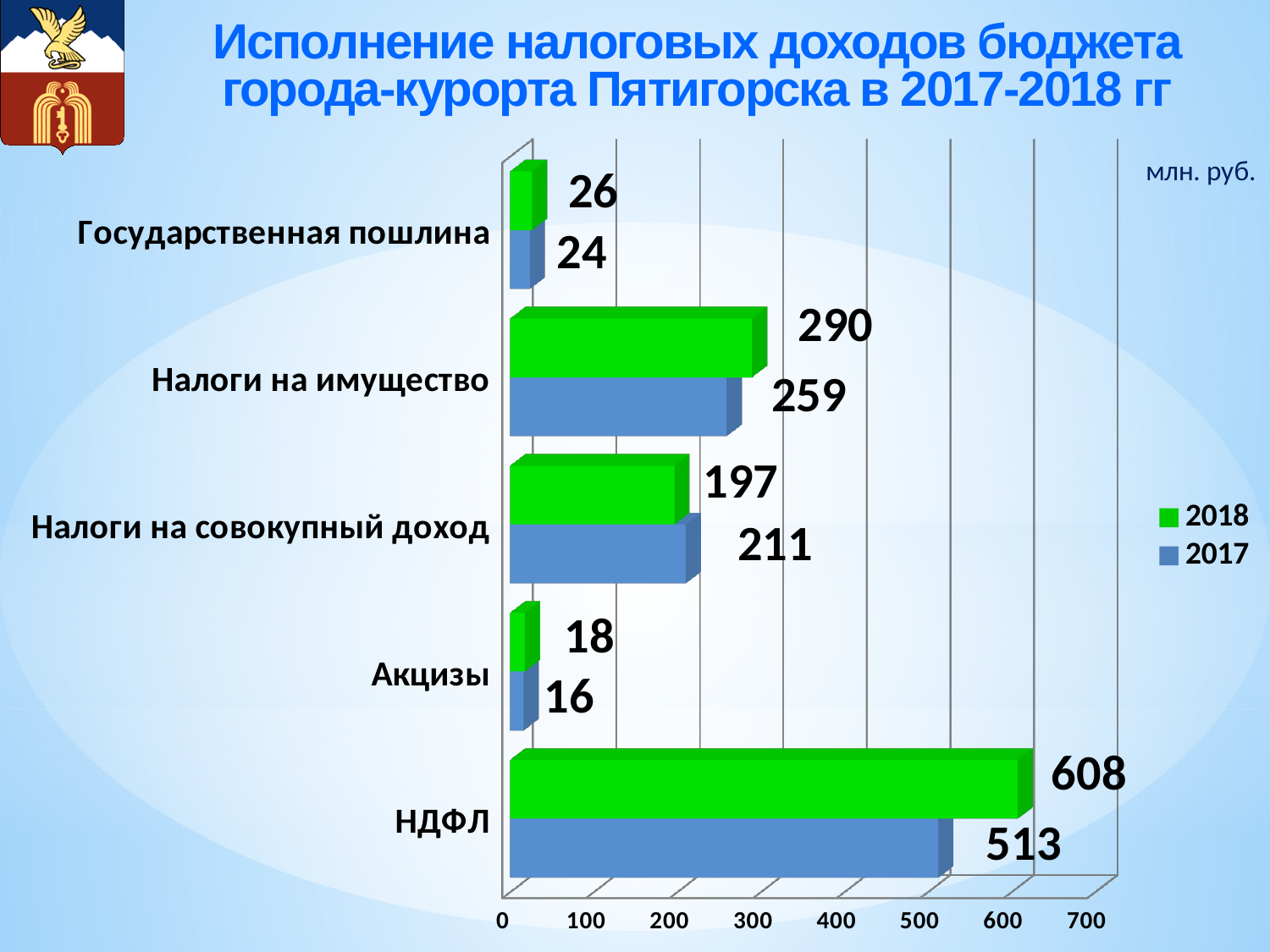
What is the 2018 value for НДФЛ? 608 Which category has the lowest 2017 value? Акцизы How many series does the legend list? 2 How many categories are shown on the chart? 5 What unit is indicated in the top right corner of the chart? млн. руб. What kind of chart is shown on the slide? Bar chart Which category has the highest 2018 value? НДФЛ What is the 2017 value for Налоги на имущество? 259 Which is larger for Налоги на совокупный доход, the 2017 value or the 2018 value? 2017 What is the 2018 value for Налоги на совокупный доход? 197 What is the difference between the 2018 and 2017 values for НДФЛ? 95 What is the 2017 value for Акцизы? 16